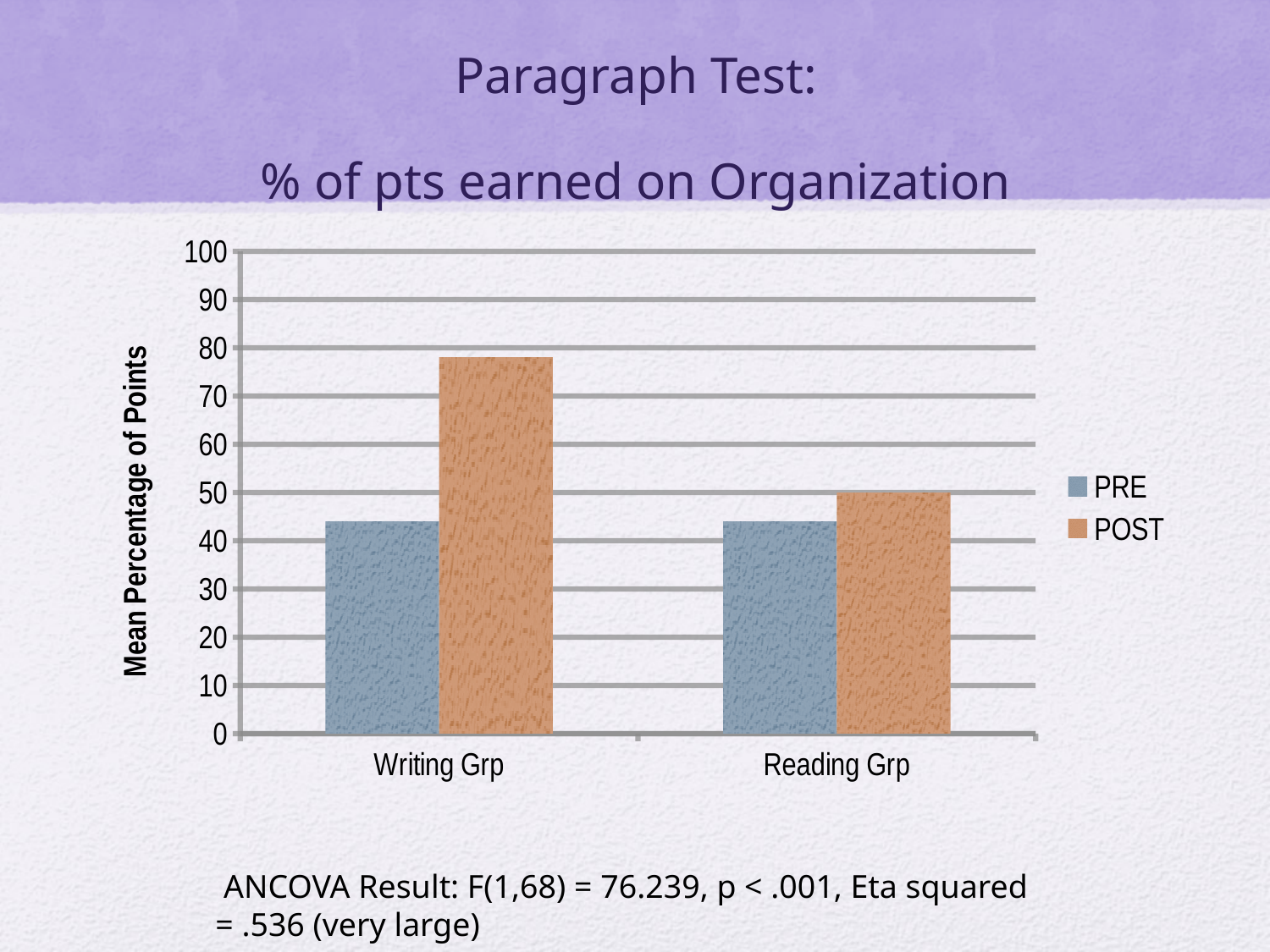
What kind of chart is shown on the slide? bar chart For Reading Grp, which is larger, the PRE value or the POST value? POST How many groups are shown on the x axis? 2 Is the PRE value for Writing Grp greater or less than 50? less What are the series names in the legend? PRE and POST Is the POST value for Writing Grp greater or less than 70? greater Which is larger, the POST value for Writing Grp or the POST value for Reading Grp? POST for Writing Grp Which bar is the highest in the chart? POST for Writing Grp Is the POST value for Reading Grp greater or less than 60? less How many series does the legend list? 2 What is the y-axis title of the chart? Mean Percentage of Points